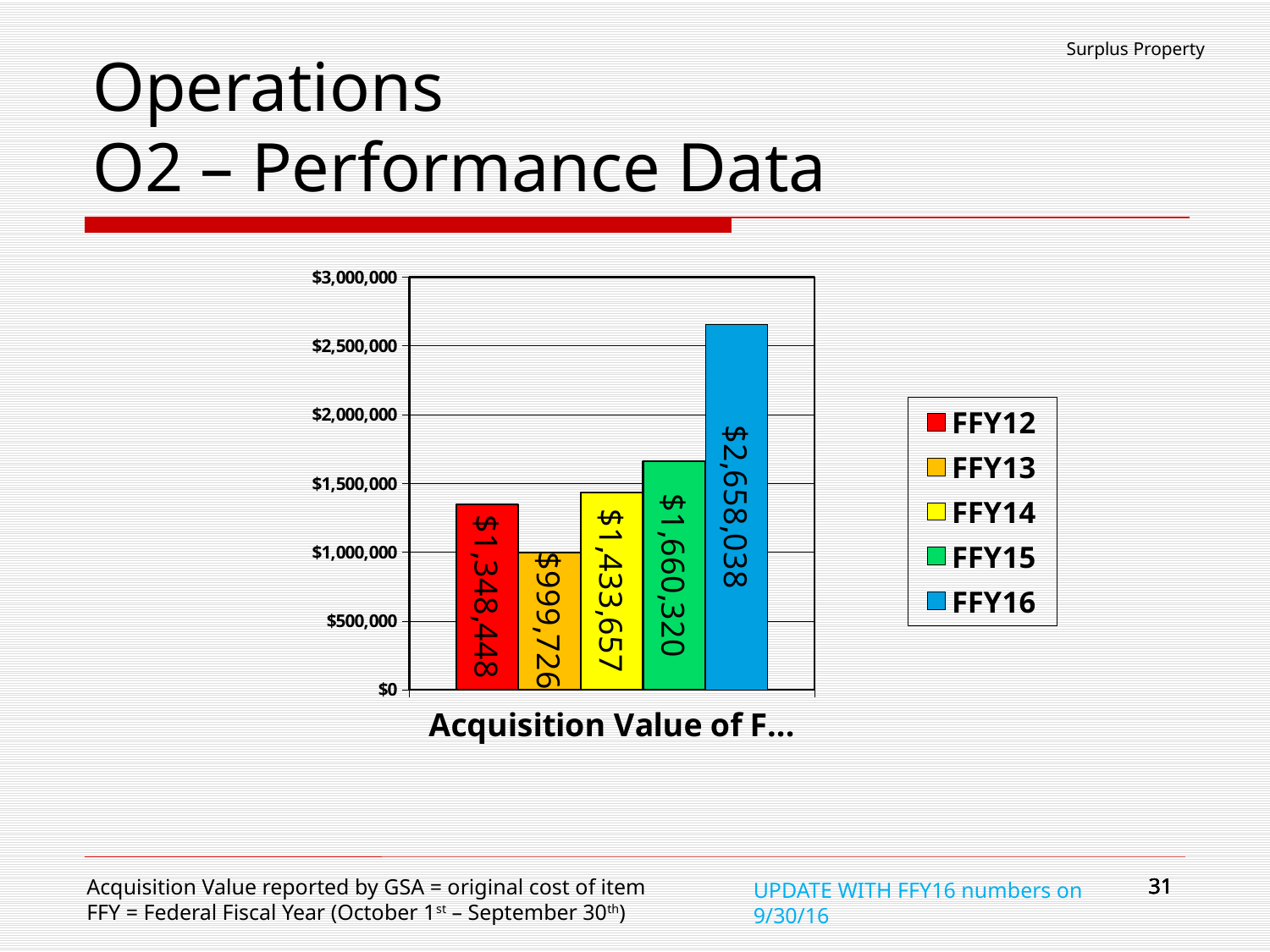
What is the difference between the FFY16 and FFY15 values? $997,718 Which fiscal year has the highest value? FFY16 What is the value for FFY16? $2,658,038 What is the value for FFY14? $1,433,657 What is the value for FFY15? $1,660,320 What is the value for FFY13? $999,726 What kind of chart is shown on the slide? Bar chart What is the value for FFY12? $1,348,448 How many series does the legend list? 5 Which is larger, the value for FFY12 or the value for FFY14? FFY14 What colour is the bar for FFY15? Green Which fiscal year has the lowest value? FFY13